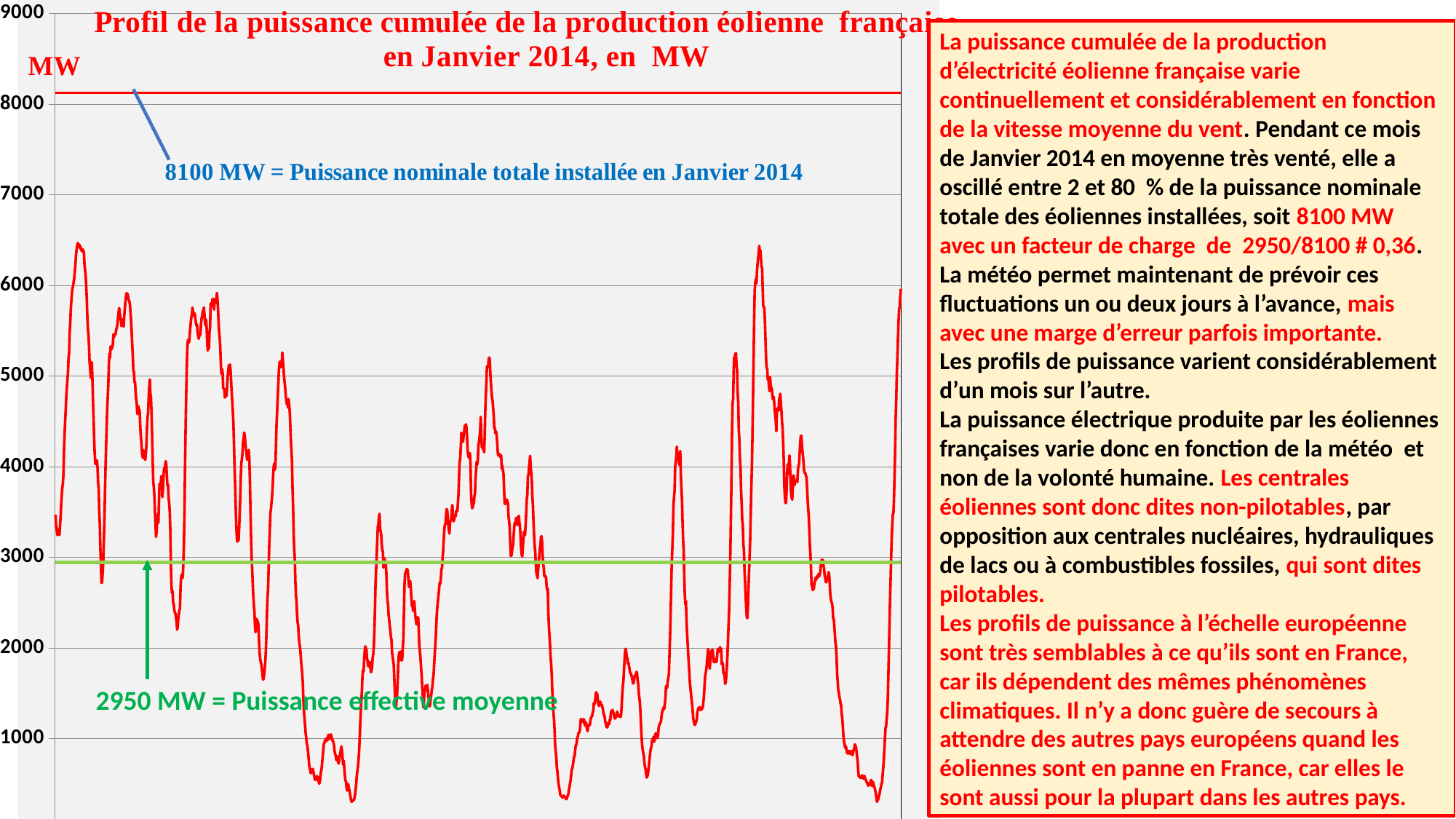
Is the highest peak of the red production line greater or less than 6000? greater Is the lowest point of the red production line greater or less than 1000? less What value is given for the 'Puissance effective moyenne' line? 2950 MW Is the highest peak of the red production line greater or less than 7000? less What kind of chart is shown on the slide? line chart What is the highest tick value shown on the vertical axis? 9000 What is the title of the chart? Profil de la puissance cumulée de la production éolienne française en Janvier 2014, en MW Which is larger, the 'Puissance nominale totale installée' or the 'Puissance effective moyenne'? Puissance nominale totale installée What value is given for the 'Puissance nominale totale installée en Janvier 2014' line? 8100 MW What unit is shown on the vertical axis of the chart? MW What is the difference between the nominal installed power (8100 MW) and the average effective power (2950 MW)? 5150 MW